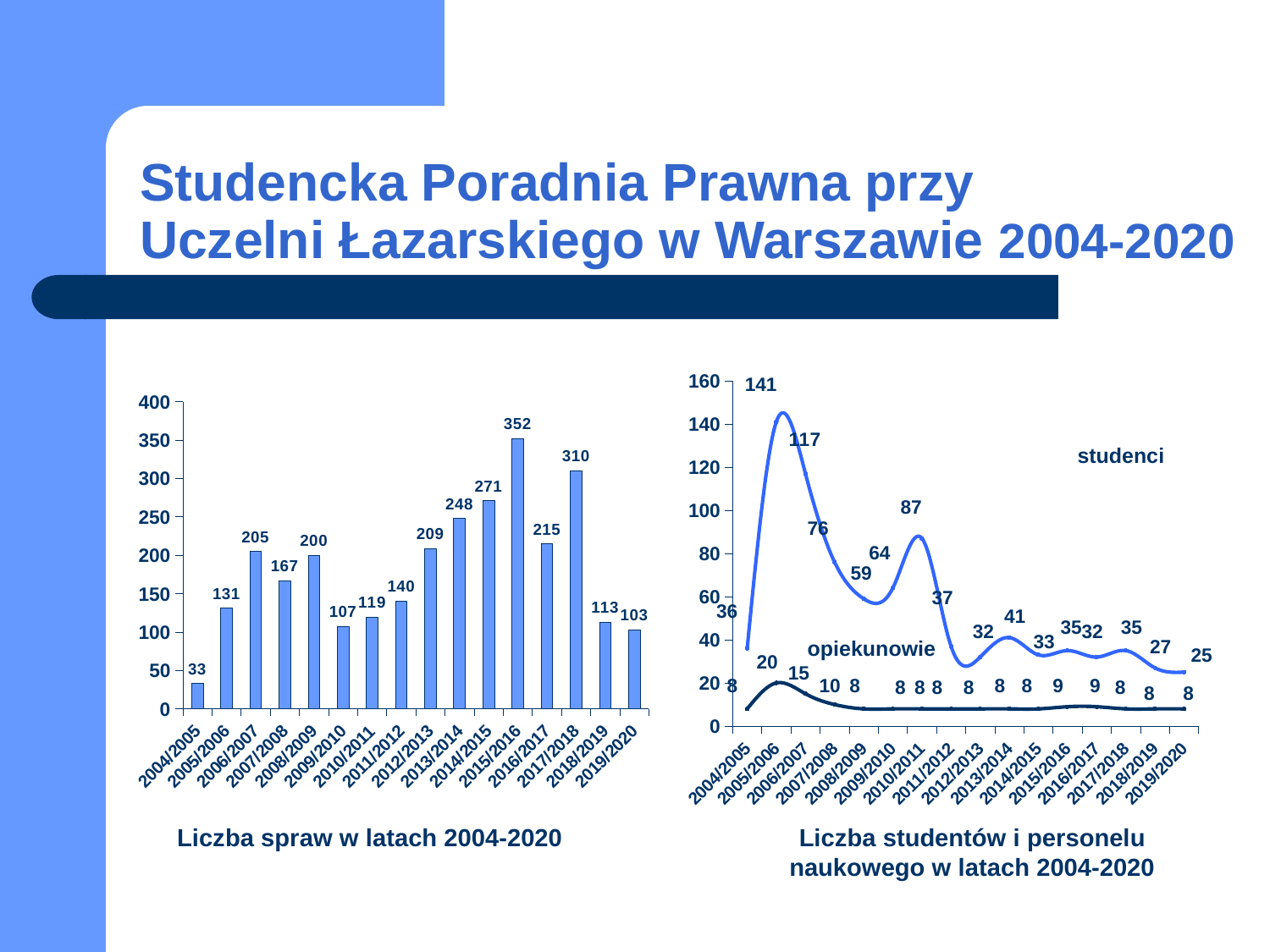
In the chart 'Liczba studentów i personelu naukowego w latach 2004-2020', what is the value of the opiekunowie series for 2005/2006? 20 What kind of chart is 'Liczba spraw w latach 2004-2020'? bar chart In the chart 'Liczba spraw w latach 2004-2020', which is larger, the value for 2006/2007 or the value for 2008/2009? 2006/2007 How many series are plotted in the chart 'Liczba studentów i personelu naukowego w latach 2004-2020'? 2 In the chart 'Liczba spraw w latach 2004-2020', what is the value for 2004/2005? 33 In the chart 'Liczba studentów i personelu naukowego w latach 2004-2020', which year has the highest value for the studenci series? 2005/2006 In the chart 'Liczba spraw w latach 2004-2020', which year has the lowest value? 2004/2005 In the chart 'Liczba spraw w latach 2004-2020', what is the value for 2015/2016? 352 In the chart 'Liczba spraw w latach 2004-2020', which year has the highest value? 2015/2016 How many years are shown on the x axis of the chart 'Liczba spraw w latach 2004-2020'? 16 In the chart 'Liczba studentów i personelu naukowego w latach 2004-2020', what is the value of the studenci series for 2005/2006? 141 In the chart 'Liczba spraw w latach 2004-2020', what is the difference between the values for 2017/2018 and 2016/2017? 95